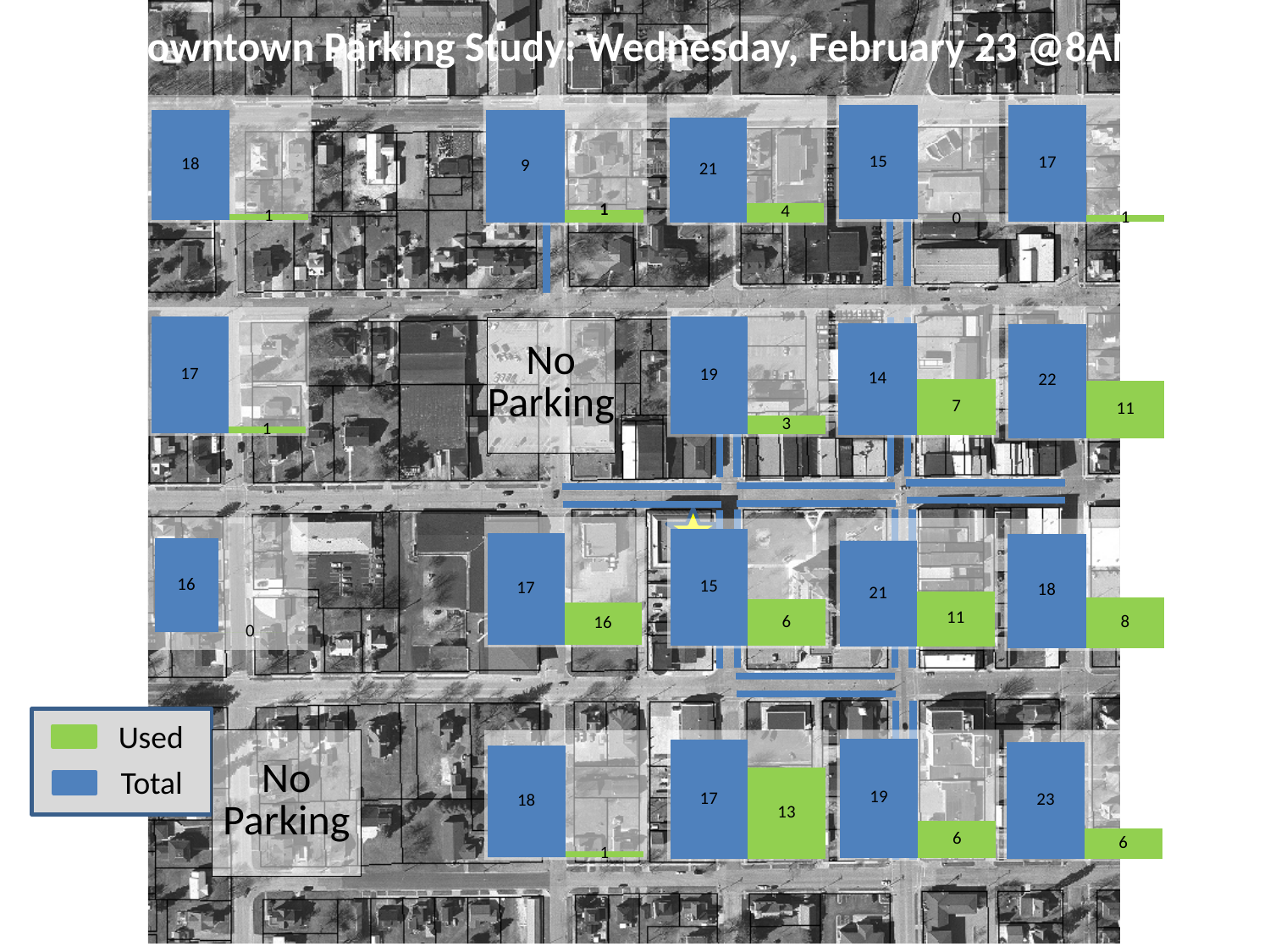
What is the Total value for the block in the bottom-right corner of the map? 23 What is the highest Total value shown on the map? 23 Which is larger: the Used value for the block with a Total of 22, or the Used value for the block with a Total of 14? The block with a Total of 22 (11) What is the Used value for the block in the top-left corner of the map? 1 What is the lowest Used value shown on the map? 0 What is the highest Used value shown on the map? 16 How many series does the legend list? 2 What is the Total value for the block in the top-left corner of the map? 18 How many areas on the map are labelled "No Parking"? 2 For the bottom-right block, what is the difference between the Total value and the Used value? 17 Which colour represents Used parking in the legend? Green What is the Used value for the block in the bottom-right corner of the map? 6